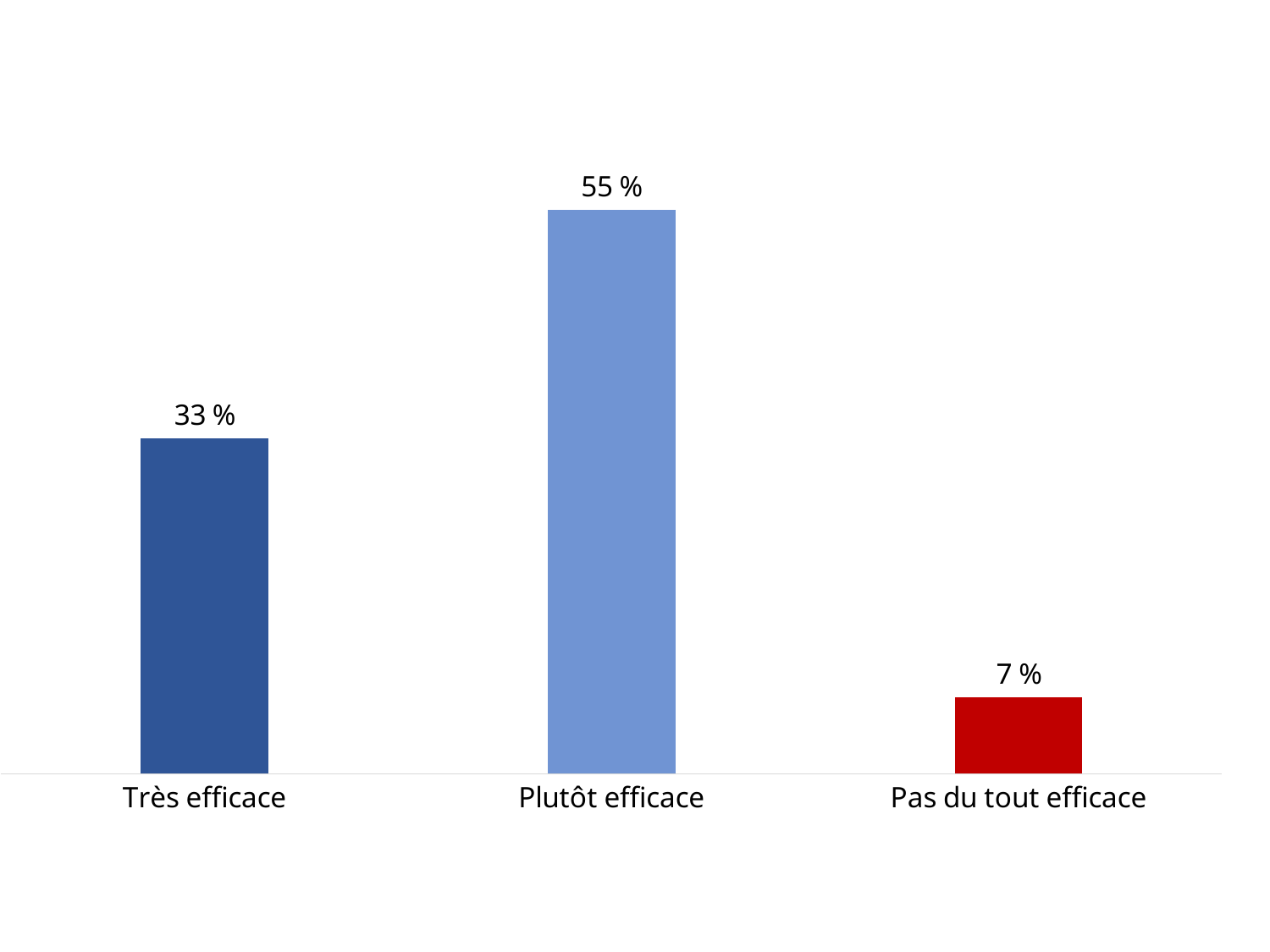
What is the difference between the values for Très efficace and Pas du tout efficace? 26 % Which category has the lowest value? Pas du tout efficace How many categories are shown in the chart? 3 What is the difference between the values for Plutôt efficace and Très efficace? 22 % Which category has the highest value? Plutôt efficace What colour is the bar for Pas du tout efficace? Red What is the value for Très efficace? 33 % What is the total of the values for Très efficace and Plutôt efficace? 88 % What is the value for Plutôt efficace? 55 % What kind of chart is shown on the slide? Bar chart Which is larger, the value for Très efficace or the value for Pas du tout efficace? Très efficace What is the value for Pas du tout efficace? 7 %